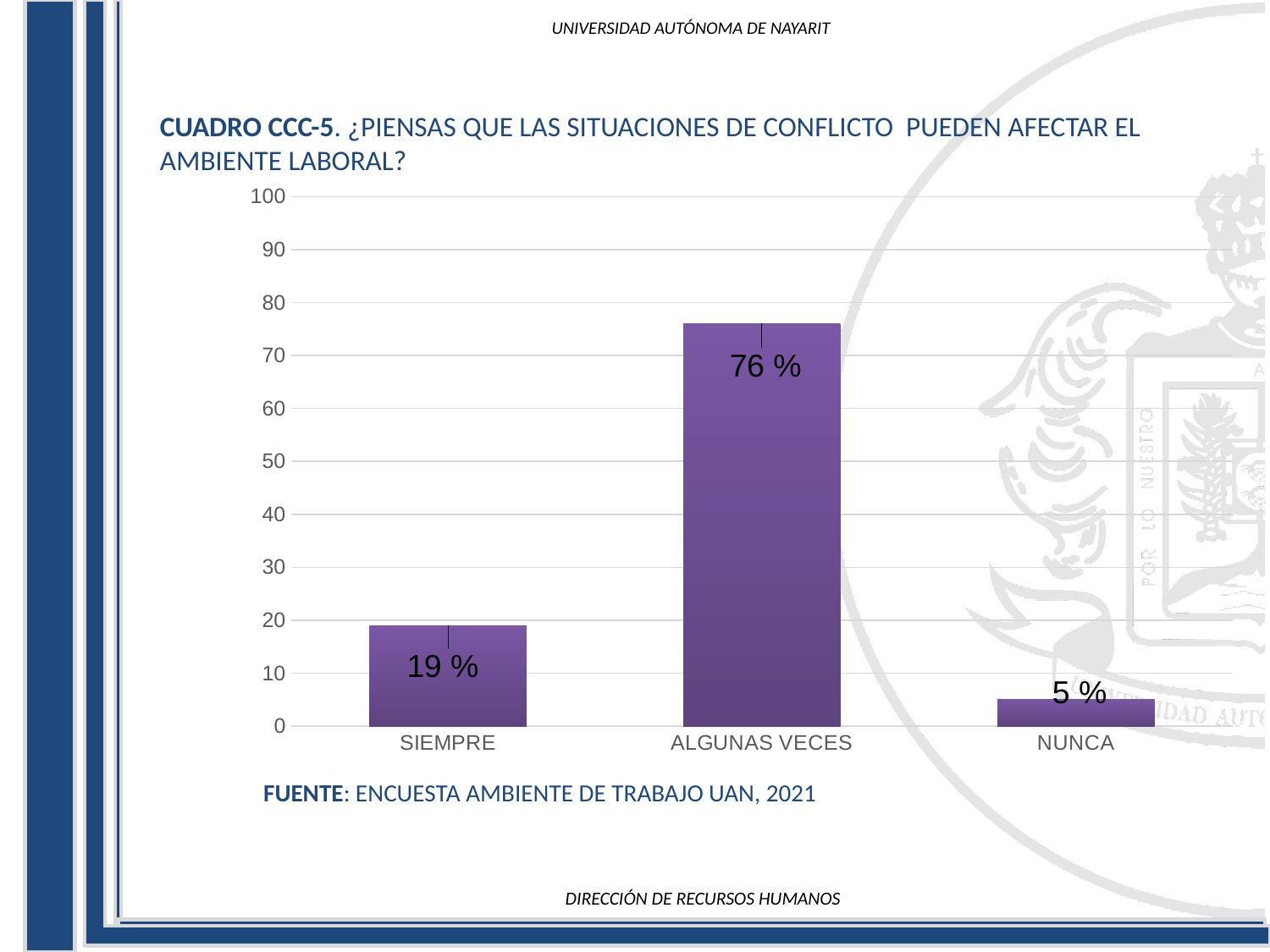
Which is larger, the value for SIEMPRE or the value for NUNCA? SIEMPRE What is the value for NUNCA? 5 % Which category has the lowest value? NUNCA Is the value for ALGUNAS VECES greater or less than 70? greater What is the value for SIEMPRE? 19 % How many categories are shown on the x axis? 3 What source is cited below the chart? ENCUESTA AMBIENTE DE TRABAJO UAN, 2021 What is the difference between the values for ALGUNAS VECES and SIEMPRE? 57 % What kind of chart is shown on the slide? bar chart What is the value for ALGUNAS VECES? 76 % What is the difference between the values for SIEMPRE and NUNCA? 14 % Which category has the highest value? ALGUNAS VECES